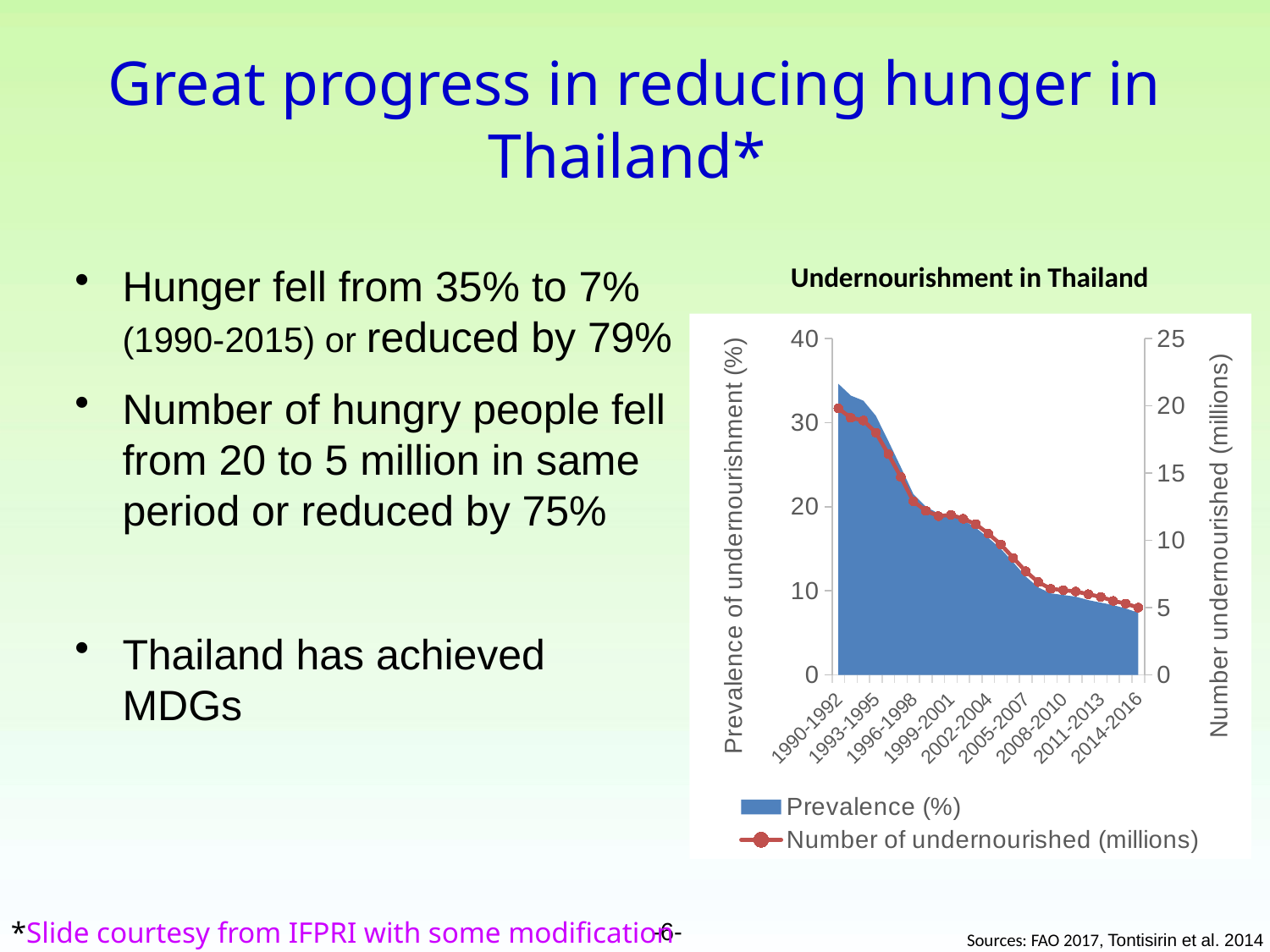
Is the prevalence of undernourishment in 1990-1992 greater or less than 30? greater Which period has the lowest number of undernourished (millions)? 2014-2016 What kind of chart is used to show the Prevalence (%) series? Area chart Is the prevalence of undernourishment in 2014-2016 greater or less than 10? less How many series does the chart's legend list? 2 Does the prevalence of undernourishment rise or fall from 1990-1992 to 2014-2016? Fall Which period has the highest prevalence of undernourishment? 1990-1992 Is the number of undernourished (millions) in 1990-1992 greater or less than 15? greater What are the two series named in the chart's legend? Prevalence (%) and Number of undernourished (millions) What is the title of the chart on the slide? Undernourishment in Thailand Which is larger, the prevalence of undernourishment in 1990-1992 or in 2014-2016? 1990-1992 Does the number of undernourished (millions) rise or fall over the period shown? Fall